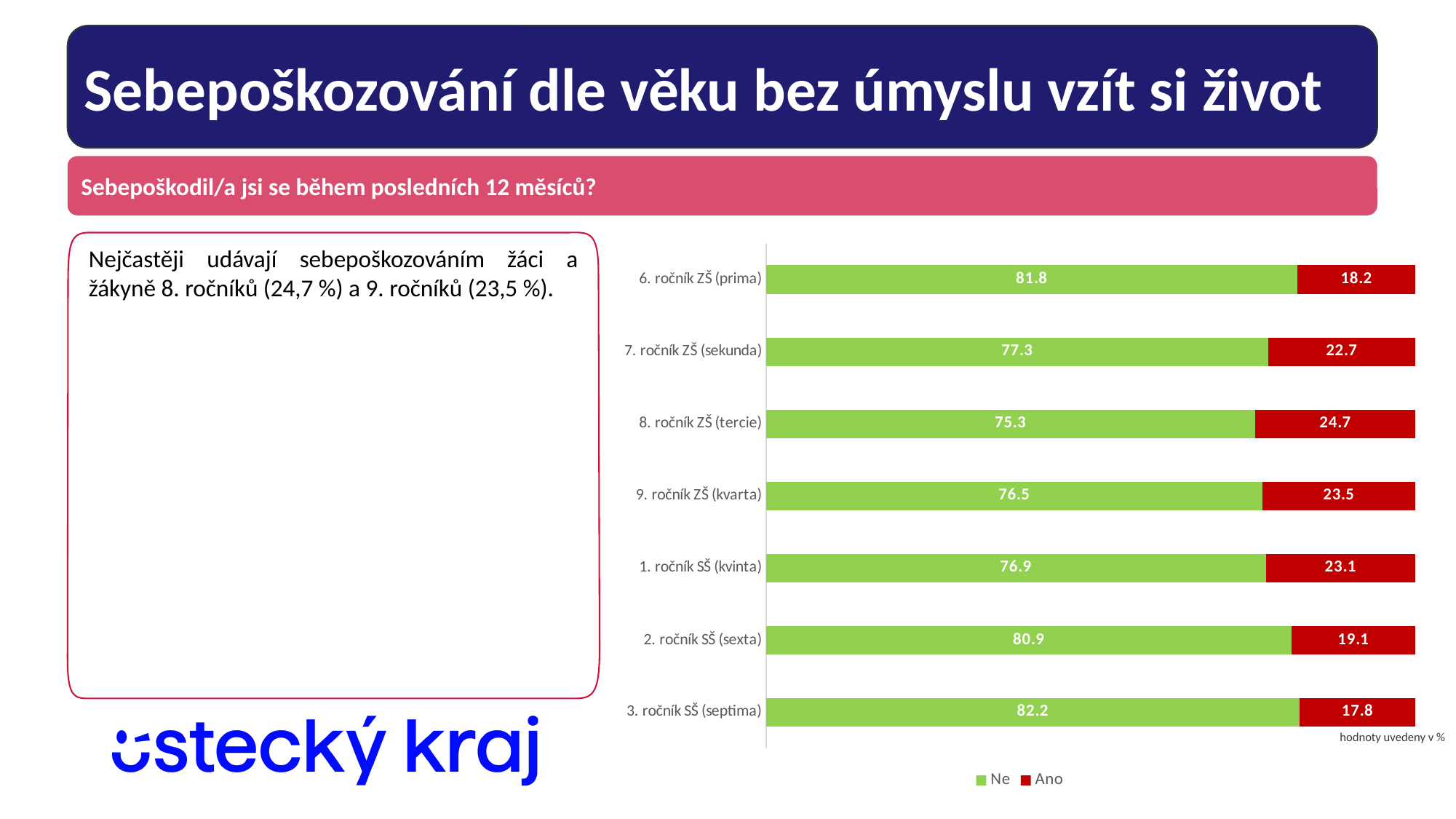
What kind of chart is shown on the slide? Stacked bar chart What is the difference between the "Ano" values for 8. ročník ZŠ (tercie) and 6. ročník ZŠ (prima)? 6.5 Which category has the highest "Ano" value? 8. ročník ZŠ (tercie) What is the value of "Ne" for 3. ročník SŠ (septima)? 82.2 What is the total of the stacked bar for 1. ročník SŠ (kvinta)? 100 Which category has the lowest "Ano" value? 3. ročník SŠ (septima) How many categories are shown on the chart? 7 Which is larger: the "Ne" value for 7. ročník ZŠ (sekunda) or for 9. ročník ZŠ (kvarta)? 7. ročník ZŠ (sekunda) What is the value of "Ano" for 2. ročník SŠ (sexta)? 19.1 What is the value of "Ano" for 8. ročník ZŠ (tercie)? 24.7 Which colour represents the "Ano" series in the legend? Red How many series does the legend list? 2